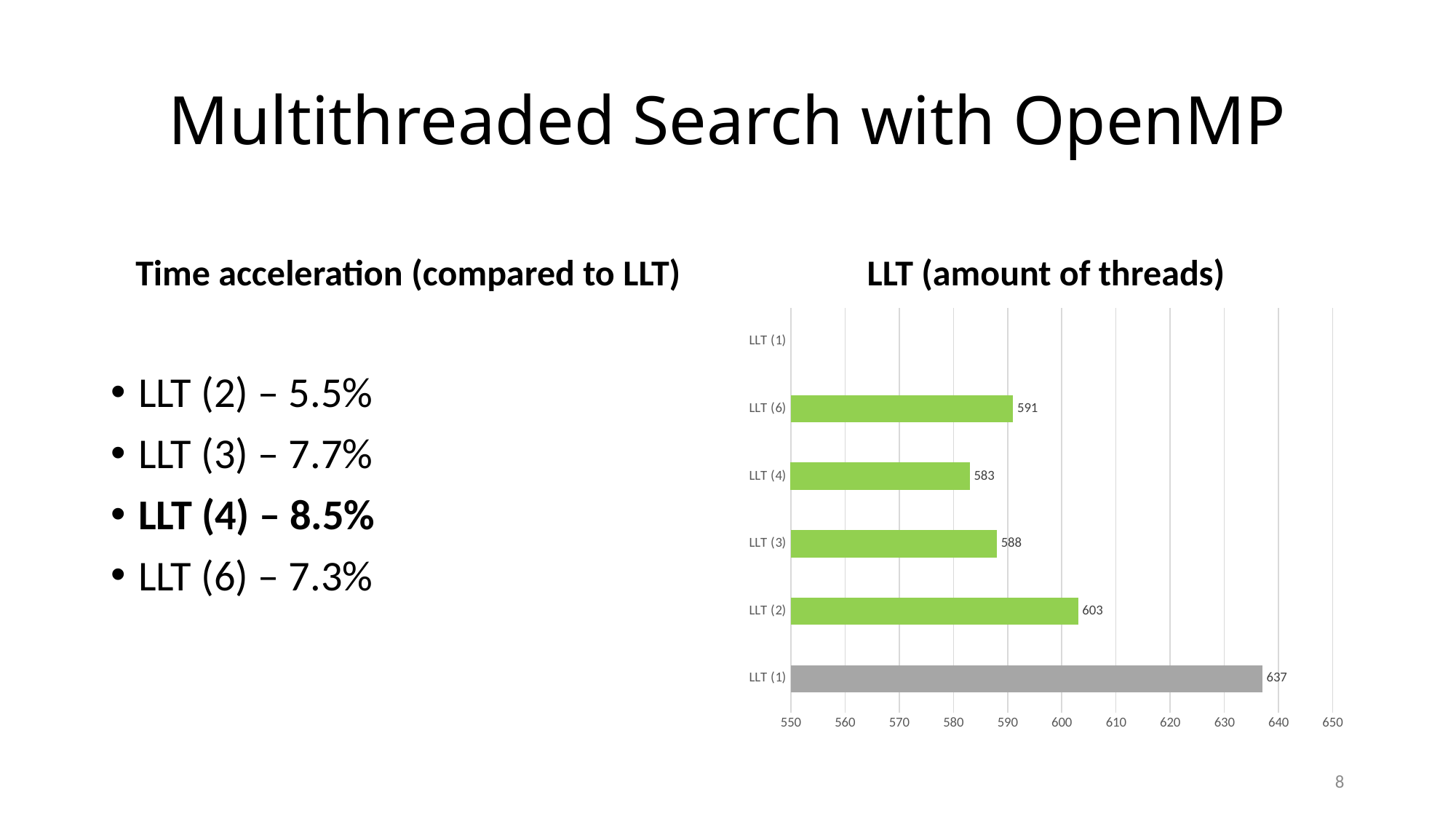
What is the value for LLT (2) in the chart? 603 What is the title of the chart? LLT (amount of threads) What is the value for LLT (6) in the chart? 591 Which is larger, the value for LLT (3) or the value for LLT (6)? LLT (6) What is the value for LLT (3) in the chart? 588 Which category has the highest value in the chart? LLT (1) Is the value for LLT (2) greater or less than 600? greater What is the difference between the values for LLT (2) and LLT (6)? 12 What kind of chart is shown on the slide? bar chart Which category has the lowest value among the plotted bars? LLT (4) What is the difference between the values for LLT (1) and LLT (4)? 54 What is the value for LLT (4) in the chart? 583